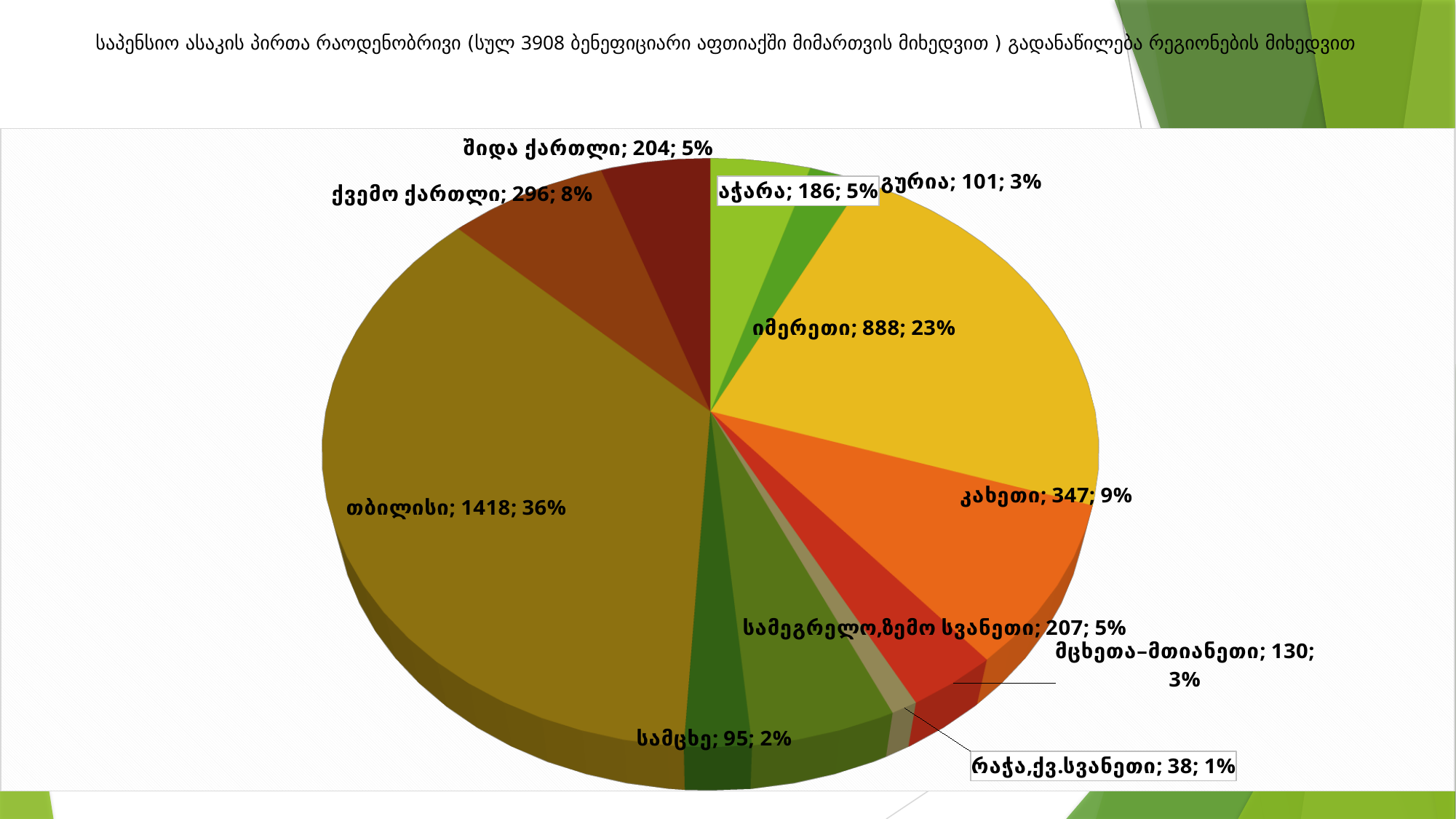
What share of the pie does მცხეთა-მთიანეთი represent? 3% What is the difference between the values for აჭარა and გურია? 85 What type of chart is shown on the slide? pie chart What is the value for სამეგრელო,ზემო სვანეთი? 207 Which region has the smallest slice? რაჭა,ქვ.სვანეთი Which region has the largest slice? თბილისი What is the value for თბილისი? 1418 How many slices does the pie chart have? 11 What is the value for კახეთი? 347 What is the difference between the values for იმერეთი and კახეთი? 541 Which is larger, the value for ქვემო ქართლი or the value for შიდა ქართლი? ქვემო ქართლი What share of the pie does იმერეთი represent? 23%